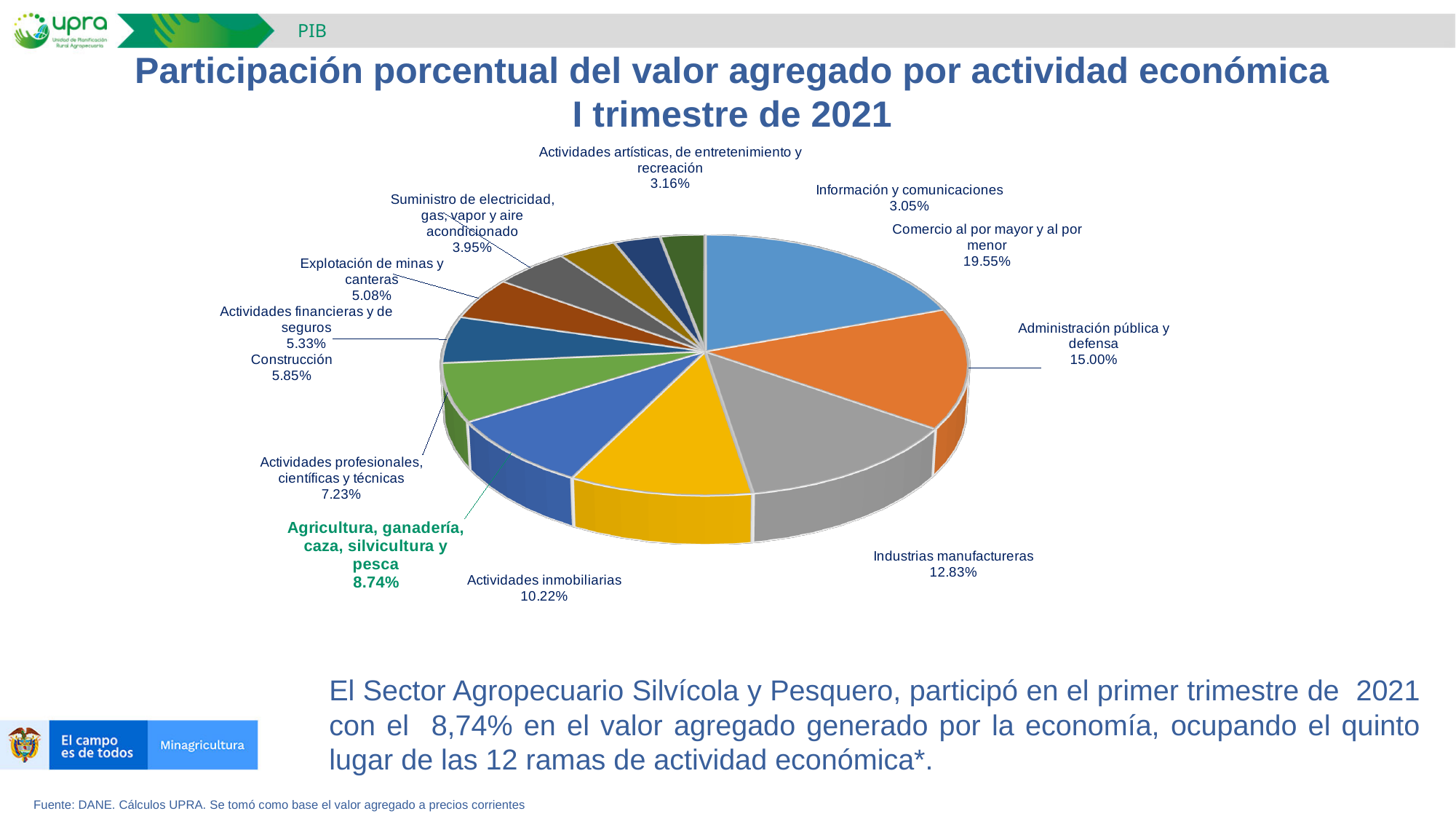
What is the title of the chart on the slide? Participación porcentual del valor agregado por actividad económica I trimestre de 2021 What is the percentage share for Agricultura, ganadería, caza, silvicultura y pesca? 8.74% What kind of chart is shown on the slide? Pie chart Which has a larger share: Construcción or Actividades financieras y de seguros? Construcción What is the percentage share for Comercio al por mayor y al por menor? 19.55% What is the percentage share for Industrias manufactureras? 12.83% How many economic activities (slices) does the pie chart show? 12 What is the percentage share for Suministro de electricidad, gas, vapor y aire acondicionado? 3.95% What is the difference in percentage points between Agricultura, ganadería, caza, silvicultura y pesca and Actividades profesionales, científicas y técnicas? 1.51 What is the difference in percentage points between Comercio al por mayor y al por menor and Administración pública y defensa? 4.55 Which economic activity has the smallest share in the pie chart? Información y comunicaciones Which economic activity has the largest share in the pie chart? Comercio al por mayor y al por menor